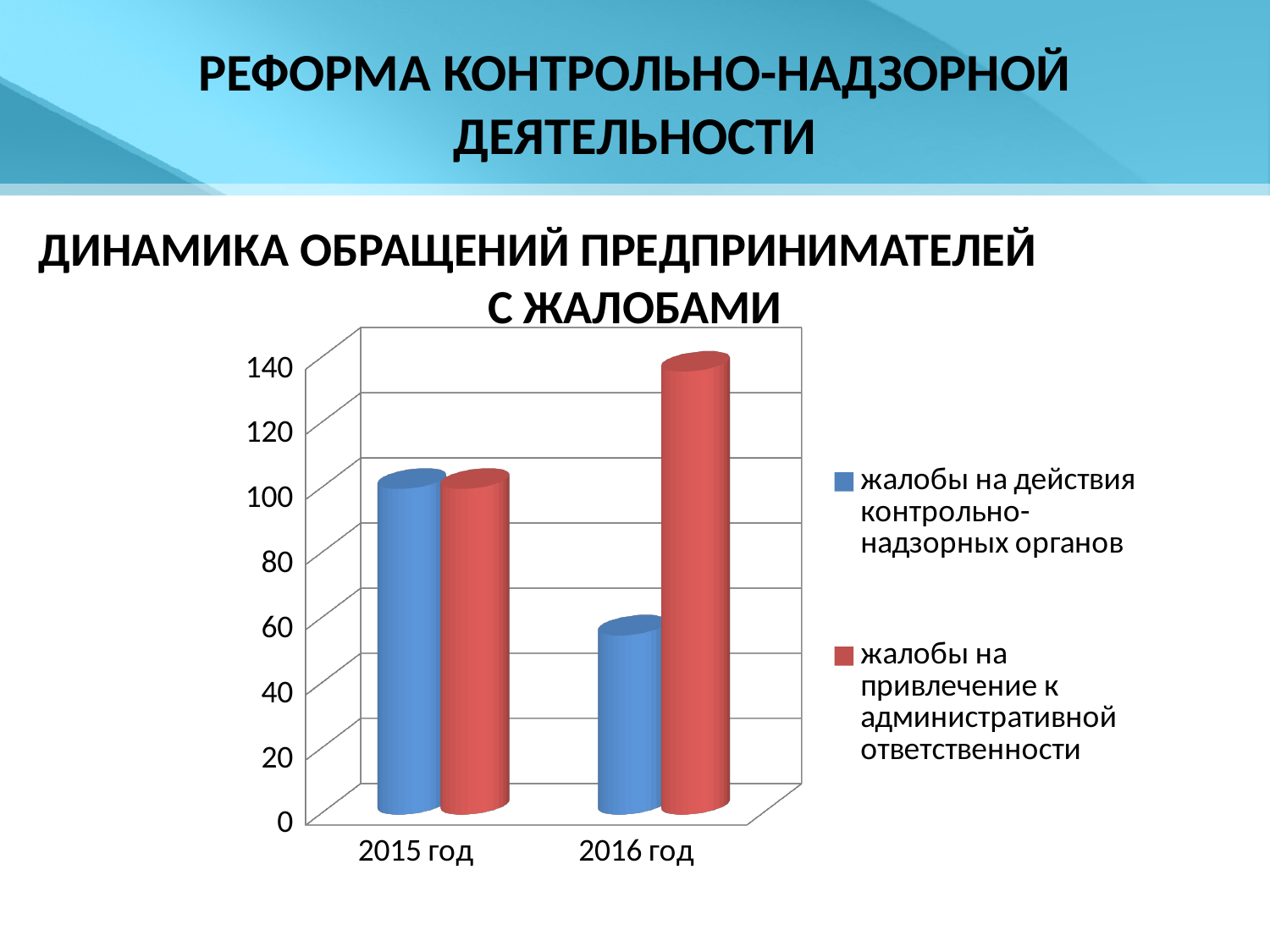
What is the title of the chart? ДИНАМИКА ОБРАЩЕНИЙ ПРЕДПРИНИМАТЕЛЕЙ С ЖАЛОБАМИ Which colour represents the series 'жалобы на привлечение к административной ответственности'? red Do the values for 'жалобы на привлечение к административной ответственности' rise or fall from 2015 год to 2016 год? rise In which year is the value for 'жалобы на привлечение к административной ответственности' highest? 2016 год Is the value for 'жалобы на привлечение к административной ответственности' in 2016 год greater or less than 120? greater Do the values for 'жалобы на действия контрольно-надзорных органов' rise or fall from 2015 год to 2016 год? fall What kind of chart is shown on the slide? bar chart In 2016 год, which series has the larger value: 'жалобы на действия контрольно-надзорных органов' or 'жалобы на привлечение к административной ответственности'? жалобы на привлечение к административной ответственности Is the value for 'жалобы на действия контрольно-надзорных органов' in 2016 год greater or less than 80? less Is the value for 'жалобы на действия контрольно-надзорных органов' in 2015 год greater or less than 80? greater How many series does the chart legend list? 2 How many categories are shown on the x axis of the chart? 2